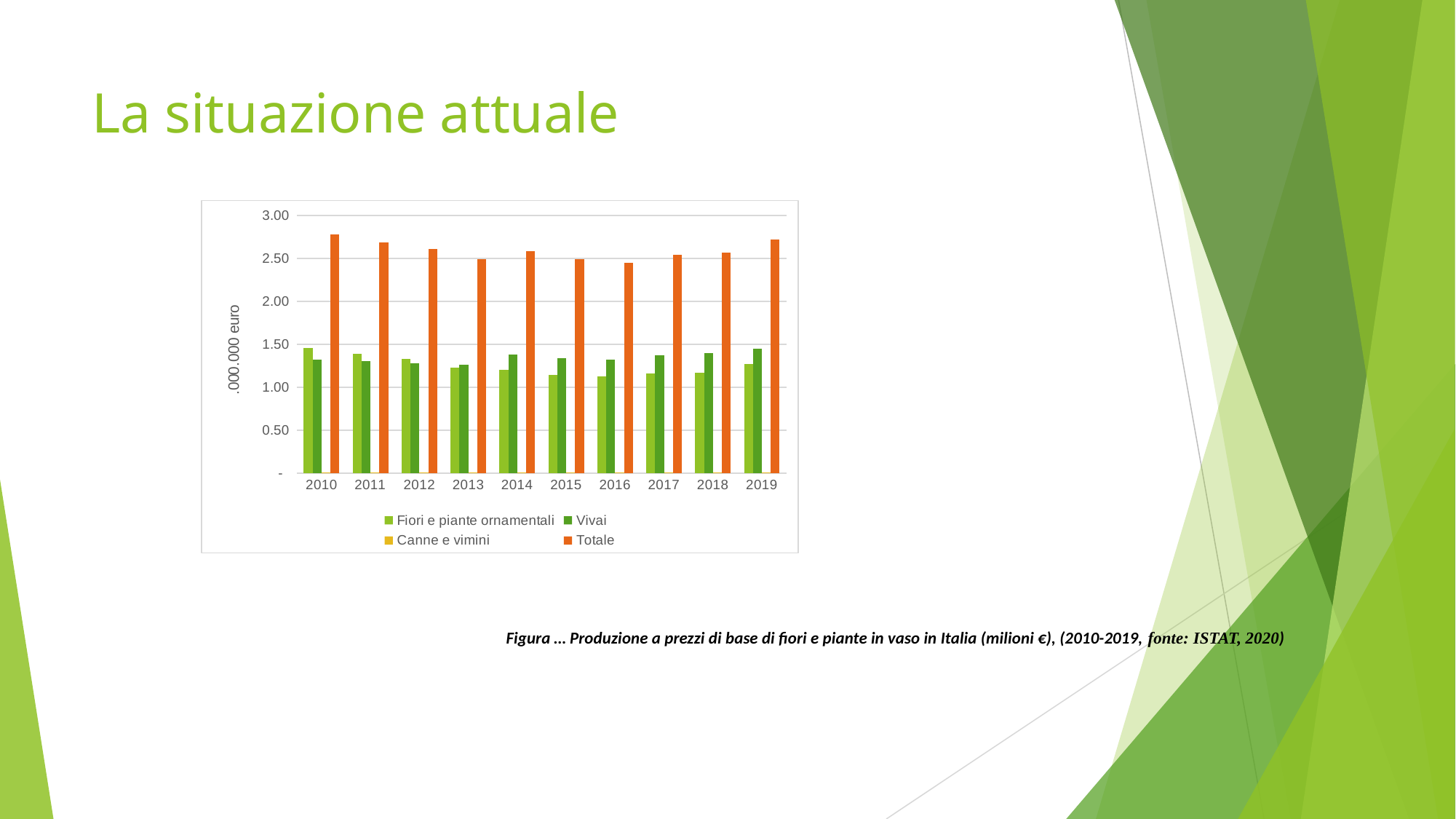
What kind of chart is shown on the slide? bar chart Is the value for Totale in 2010 greater or less than 2.50? greater What is the label on the vertical axis of the chart? .000.000 euro How many series does the chart's legend list? 4 In 2010, which is larger: Fiori e piante ornamentali or Vivai? Fiori e piante ornamentali In 2019, which is larger: Fiori e piante ornamentali or Vivai? Vivai Is the value for Fiori e piante ornamentali in 2016 greater or less than 1.00? greater Do the values for Fiori e piante ornamentali generally rise or fall from 2010 to 2016? fall How many years are shown on the x axis of the chart? 10 Is the value for Fiori e piante ornamentali in 2010 greater or less than 1.50? less Which is larger: Totale in 2010 or Totale in 2016? Totale in 2010